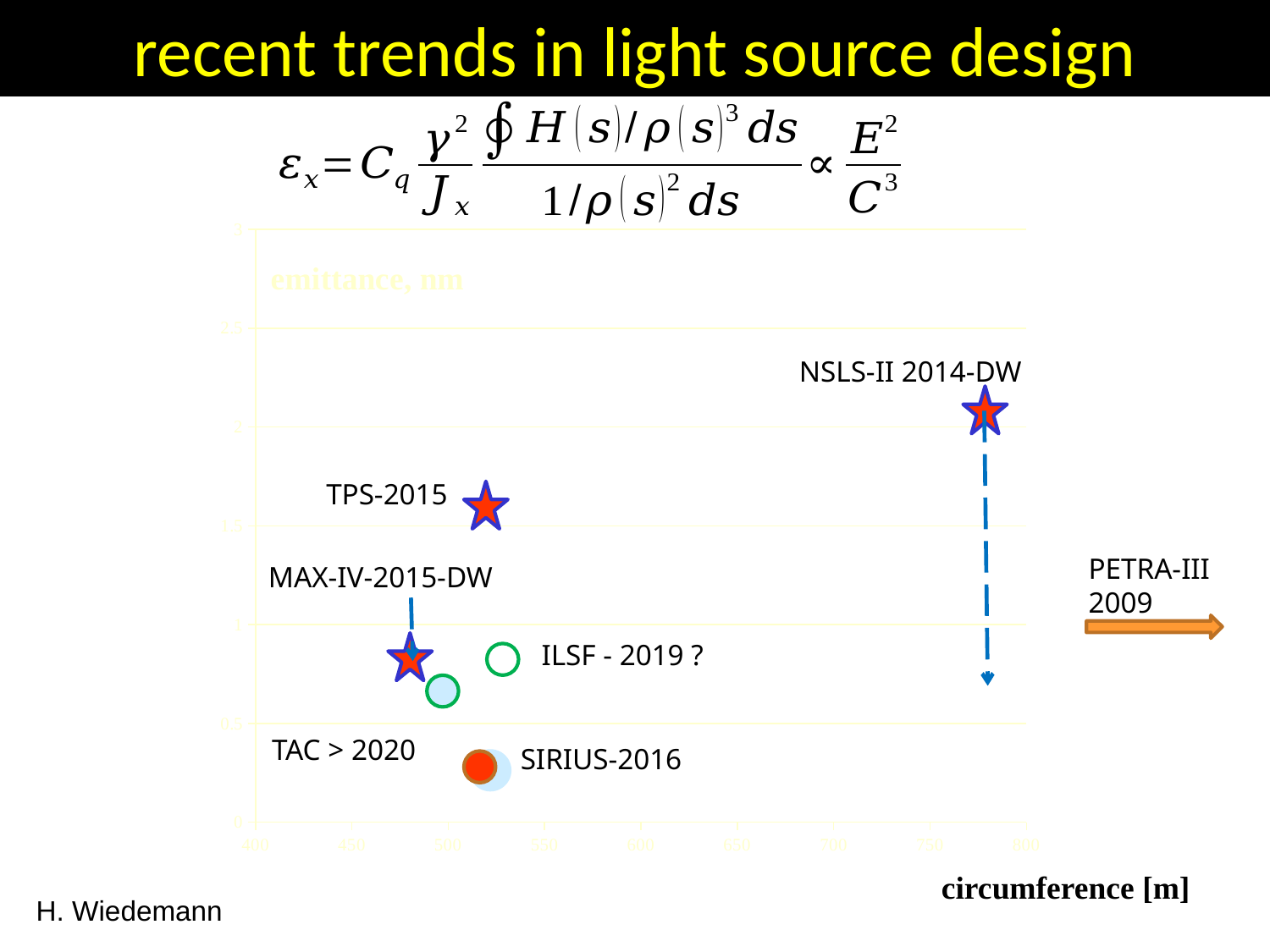
Is the emittance for MAX-IV-2015-DW greater or less than 1 nm? less Is the emittance for NSLS-II 2014-DW greater or less than 1.5 nm? greater Which labeled light source has the lowest emittance on the chart? SIRIUS-2016 Is the emittance for SIRIUS-2016 greater or less than 0.5 nm? less What quantity is plotted on the vertical axis of the chart? emittance, nm Which labeled light source has the highest emittance on the chart? NSLS-II 2014-DW What kind of chart is shown on the slide? scatter chart What quantity is plotted on the horizontal axis of the chart? circumference [m] Which has the higher emittance, TPS-2015 or MAX-IV-2015-DW? TPS-2015